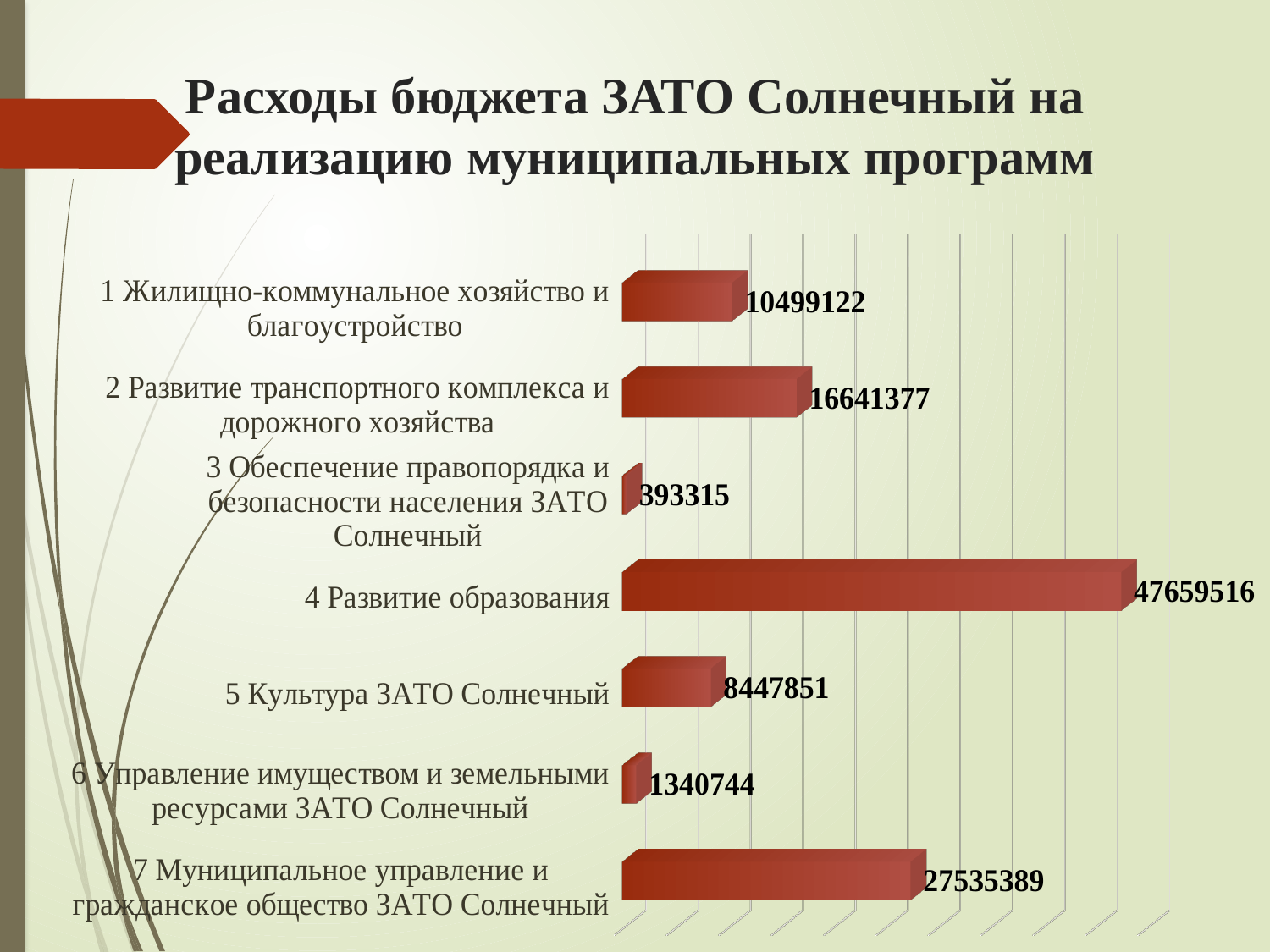
What kind of chart is shown on the slide? Bar chart How many categories are shown in the chart? 7 What is the title of the slide? Расходы бюджета ЗАТО Солнечный на реализацию муниципальных программ Which category has the highest value? 4 Развитие образования What is the difference between the values for "2 Развитие транспортного комплекса и дорожного хозяйства" and "1 Жилищно-коммунальное хозяйство и благоустройство"? 6142255 Which category has the lowest value? 3 Обеспечение правопорядка и безопасности населения ЗАТО Солнечный What is the value for "5 Культура ЗАТО Солнечный"? 8447851 What is the difference between the values for "4 Развитие образования" and "7 Муниципальное управление и гражданское общество ЗАТО Солнечный"? 20124127 Which is larger: the value for "1 Жилищно-коммунальное хозяйство и благоустройство" or for "5 Культура ЗАТО Солнечный"? 1 Жилищно-коммунальное хозяйство и благоустройство What is the value for "7 Муниципальное управление и гражданское общество ЗАТО Солнечный"? 27535389 What is the value for "3 Обеспечение правопорядка и безопасности населения ЗАТО Солнечный"? 393315 What is the value for "4 Развитие образования"? 47659516